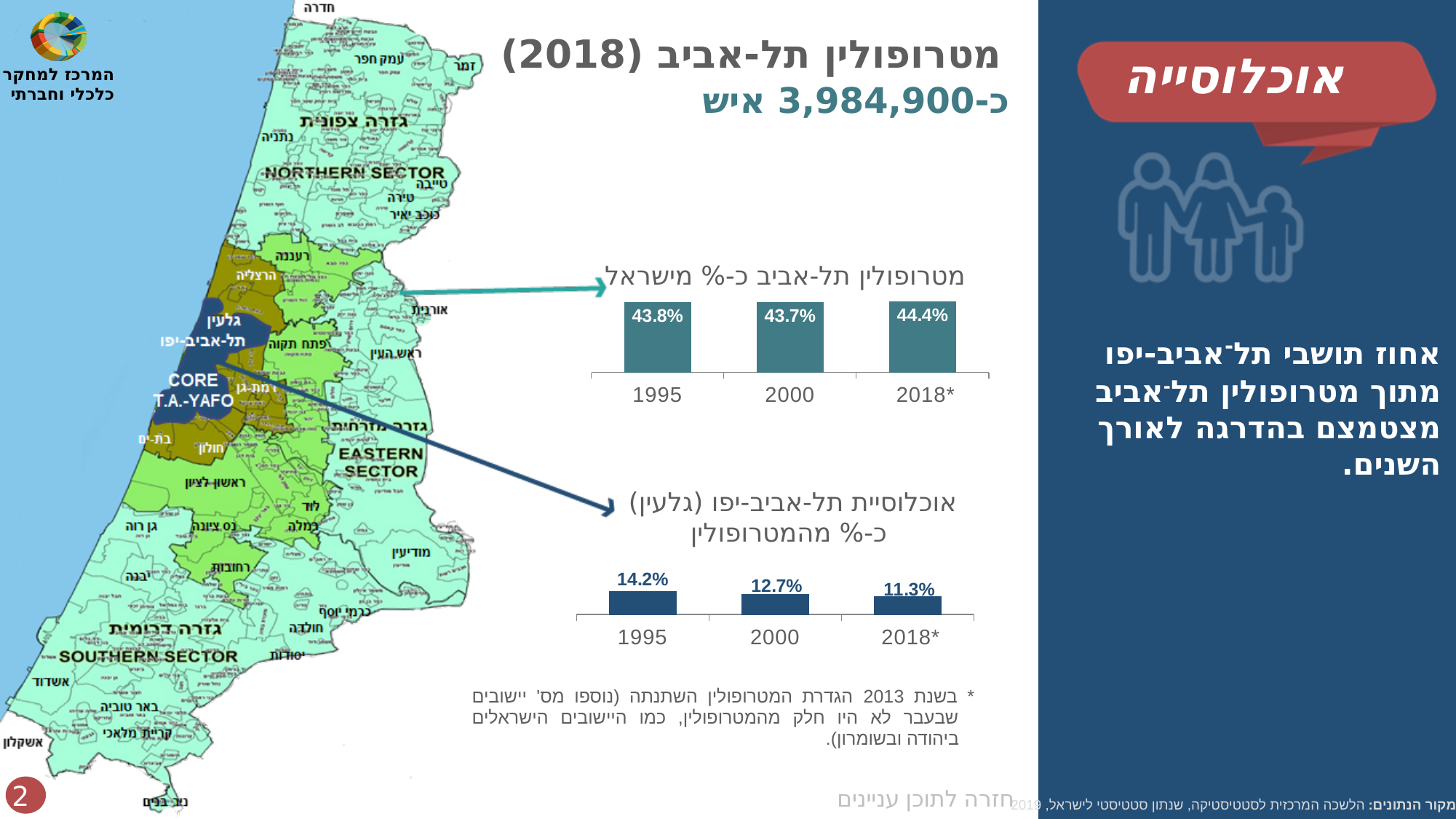
In the upper chart (Tel Aviv metropolitan area as % of Israel), is the value for 2000 larger or smaller than the value for 2018*? smaller In the upper chart (Tel Aviv metropolitan area as % of Israel), which year has the highest value? 2018* In the lower chart (Tel Aviv-Yafo core population as % of the metropolitan area), what is the difference between the 1995 and 2018* values? 2.9% In the lower chart (Tel Aviv-Yafo core population as % of the metropolitan area), what is the value for 2018*? 11.3% In the lower chart (Tel Aviv-Yafo core population as % of the metropolitan area), do the values rise or fall from 1995 to 2018*? fall In the upper chart (Tel Aviv metropolitan area as % of Israel), what is the value for 1995? 43.8% In the lower chart (Tel Aviv-Yafo core population as % of the metropolitan area), what is the value for 2000? 12.7% How many bars does the lower chart (Tel Aviv-Yafo core population as % of the metropolitan area) have? 3 In the upper chart (Tel Aviv metropolitan area as % of Israel), which year has the lowest value? 2000 What kind of chart is the upper chart (Tel Aviv metropolitan area as % of Israel)? bar chart In the lower chart (Tel Aviv-Yafo core population as % of the metropolitan area), which year has the highest value? 1995 In the upper chart (Tel Aviv metropolitan area as % of Israel), what is the value for 2018*? 44.4%